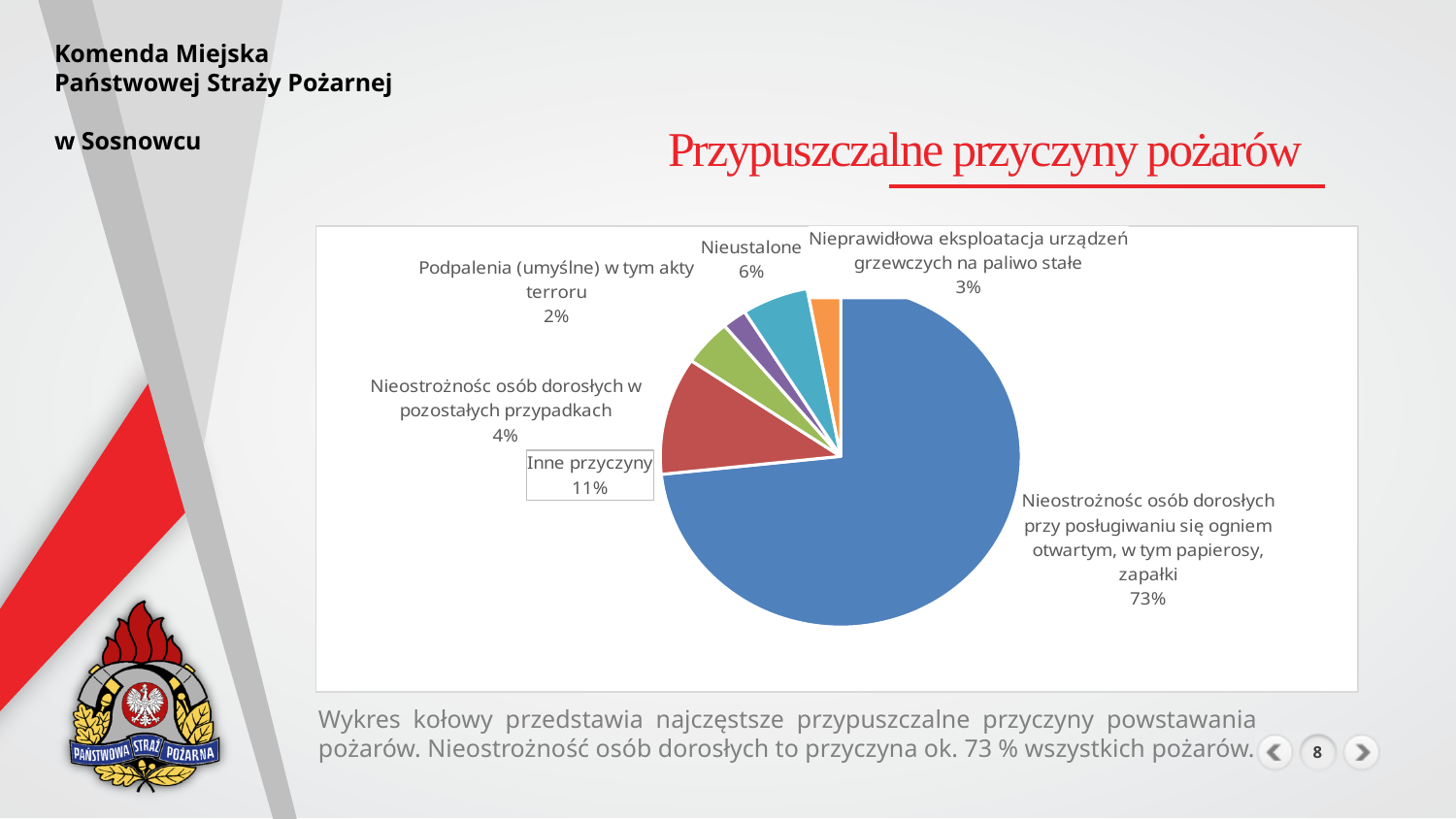
What is the title of the chart? Przypuszczalne przyczyny pożarów What percentage is shown for "Nieostrożność osób dorosłych w pozostałych przypadkach"? 4% What share of the pie is labelled "Inne przyczyny"? 11% What percentage is shown for "Nieustalone"? 6% What is the difference in percentage points between "Inne przyczyny" and "Nieustalone"? 5 What kind of chart is shown on the slide? pie chart Which category has the largest slice of the pie? Nieostrożność osób dorosłych przy posługiwaniu się ogniem otwartym, w tym papierosy, zapałki How many slices does the pie chart have? 6 What percentage is shown for "Nieprawidłowa eksploatacja urządzeń grzewczych na paliwo stałe"? 3% Which is larger: the share for "Nieustalone" or the share for "Nieostrożność osób dorosłych w pozostałych przypadkach"? Nieustalone Which category has the smallest slice of the pie? Podpalenia (umyślne) w tym akty terroru What percentage is shown for "Podpalenia (umyślne) w tym akty terroru"? 2%